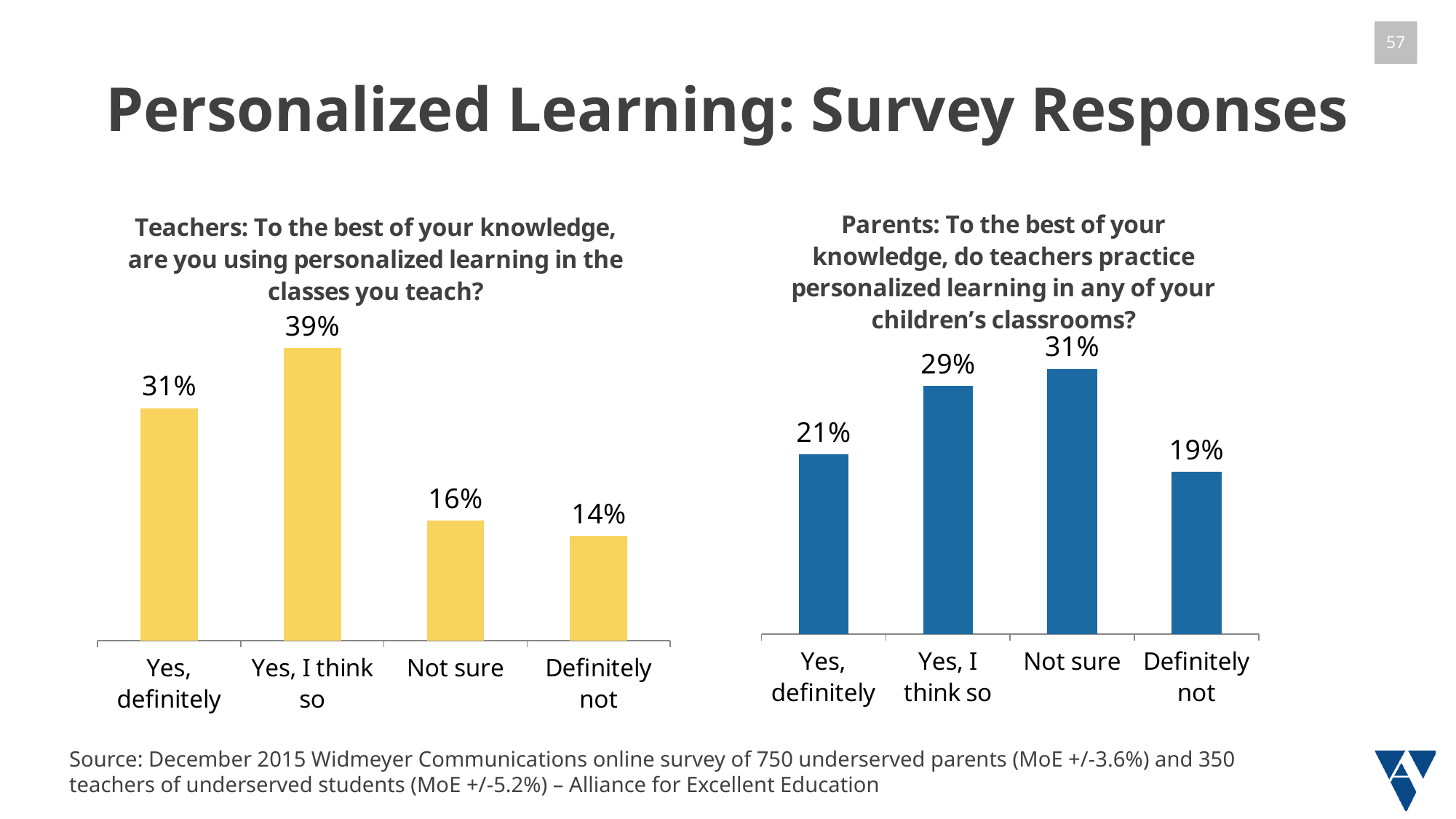
In the Teachers chart on the left, what percentage of teachers answered "Yes, definitely"? 31% What kind of chart is the Parents chart on the right? Bar chart In the Teachers chart on the left, what is the difference between "Yes, I think so" and "Yes, definitely"? 8% How many response categories are shown in the Teachers chart on the left? 4 In the Parents chart on the right, which is larger: "Yes, definitely" or "Definitely not"? Yes, definitely In the Teachers chart on the left, what percentage of teachers answered "Yes, I think so"? 39% In the Parents chart on the right, which response category has the highest value? Not sure In the Teachers chart on the left, which response category has the lowest value? Definitely not In the Parents chart on the right, what is the difference between "Yes, I think so" and "Definitely not"? 10% Which is larger: the "Not sure" value in the Teachers chart or the "Not sure" value in the Parents chart? Parents chart What colour are the bars in the Parents chart on the right? Blue In the Parents chart on the right, what percentage of parents answered "Not sure"? 31%